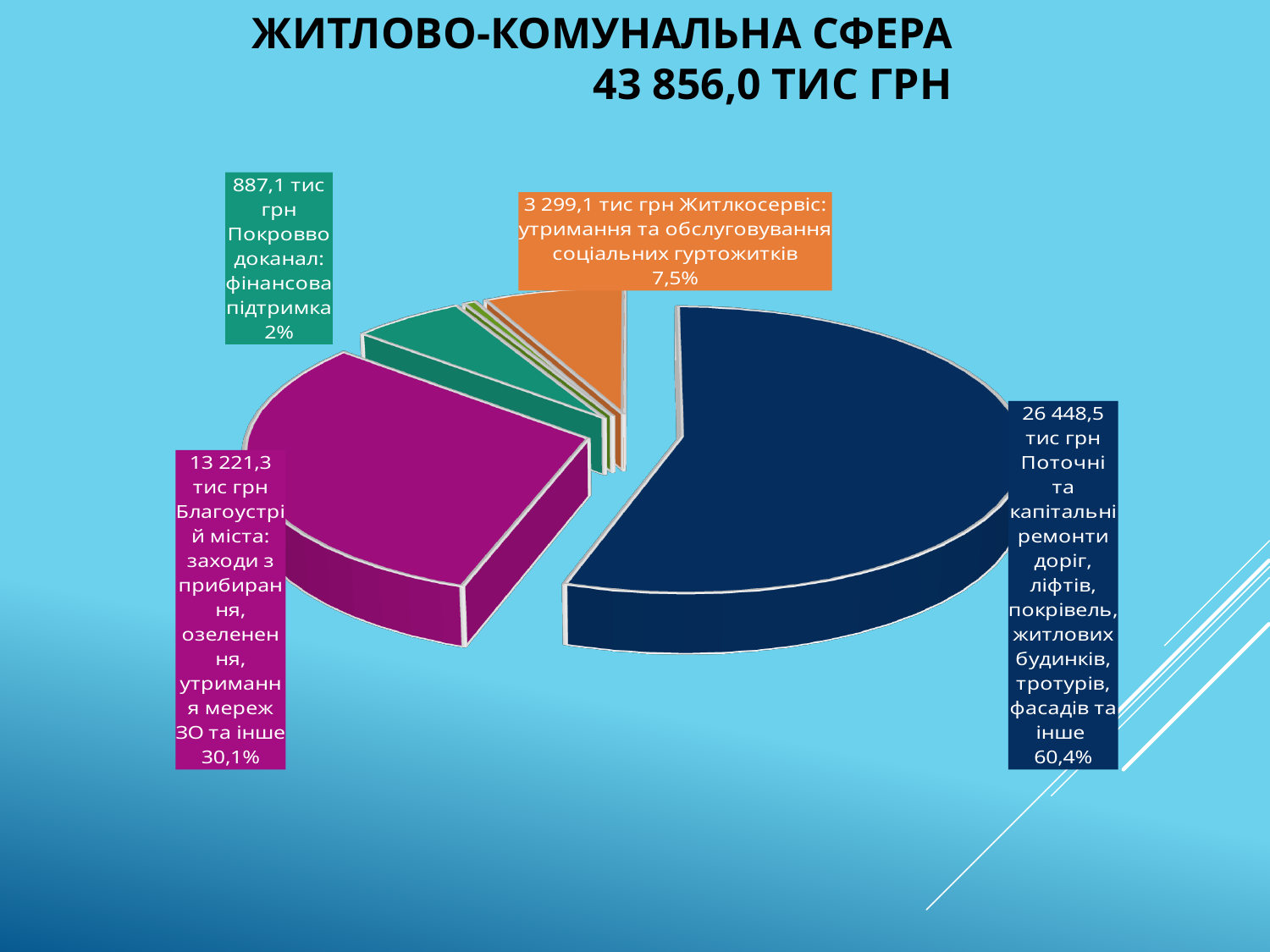
What kind of chart is shown on the slide? pie chart What share of the pie does Поточні та капітальні ремонти доріг, ліфтів, покрівель, житлових будинків, тротурів, фасадів та інше take? 60,4% What share of the pie does Благоустрій міста take? 30,1% What amount is labelled for Житлкосервіс: утримання та обслуговування соціальних гуртожитків? 3 299,1 тис грн Which is larger, the amount for Благоустрій міста or the amount for Житлкосервіс? Благоустрій міста What is the total amount shown in the chart title? 43 856,0 тис грн What amount is labelled for Поточні та капітальні ремонти доріг, ліфтів, покрівель, житлових будинків, тротурів, фасадів та інше? 26 448,5 тис грн What amount is labelled for Благоустрій міста? 13 221,3 тис грн Which labelled category has the largest slice of the pie? Поточні та капітальні ремонти доріг, ліфтів, покрівель, житлових будинків, тротурів, фасадів та інше What is the title of the chart on the slide? ЖИТЛОВО-КОМУНАЛЬНА СФЕРА 43 856,0 ТИС ГРН What share of the pie does Житлкосервіс: утримання та обслуговування соціальних гуртожитків take? 7,5%